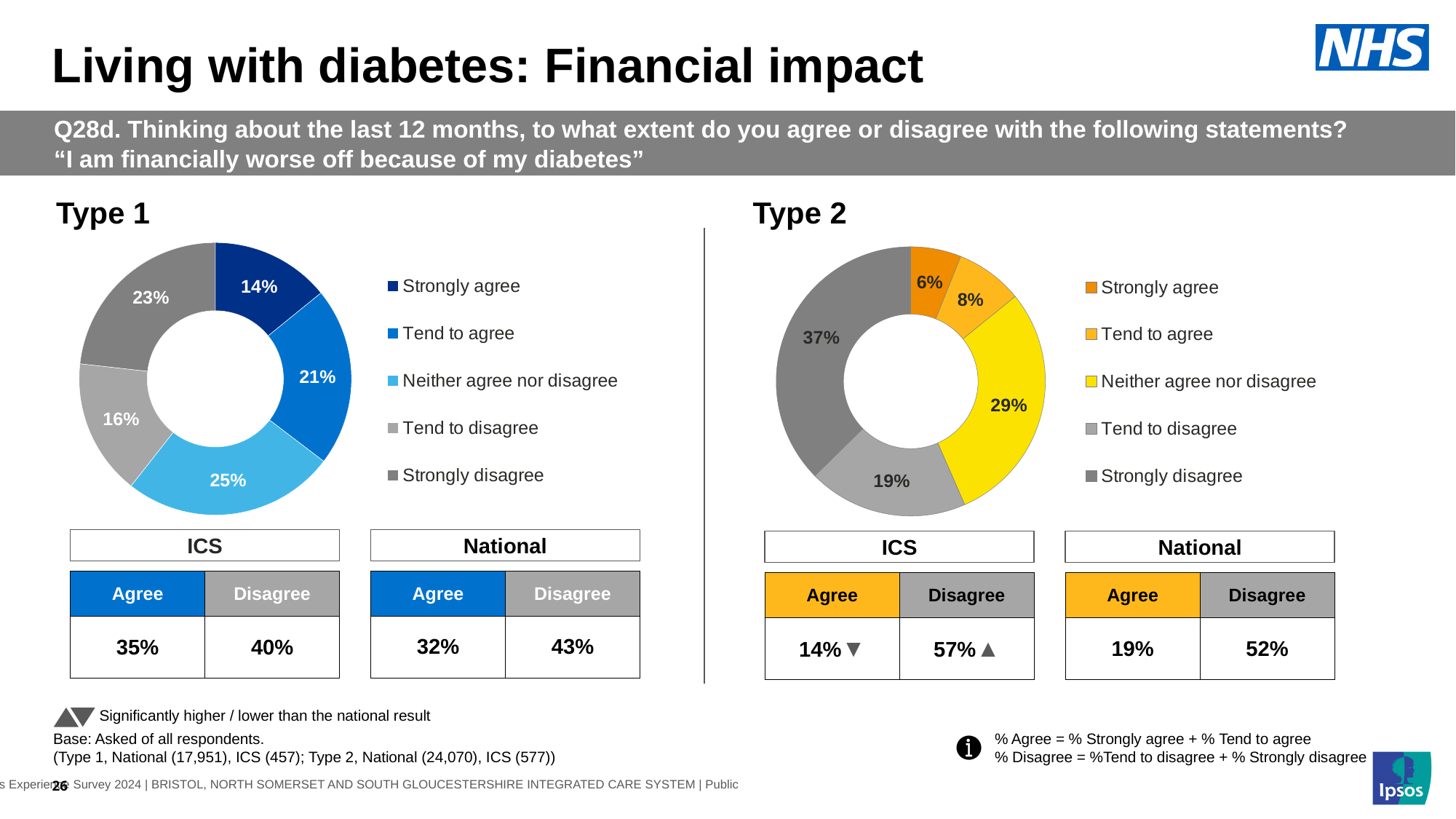
In the Type 1 chart, what percentage of respondents said 'Strongly agree'? 14% In the Type 1 chart, which response category has the largest share? Neither agree nor disagree In the Type 2 chart, what percentage of respondents said 'Tend to agree'? 8% What kind of chart is used for the Type 1 data? Donut (pie) chart In the Type 2 chart, what colour represents 'Neither agree nor disagree'? Yellow In the Type 2 chart, what is the difference between the 'Strongly disagree' share and the 'Tend to disagree' share? 18% In the Type 1 chart, what is the difference between the 'Strongly disagree' share and the 'Tend to disagree' share? 7% How many response categories are shown in the Type 2 chart? 5 Which is larger in the Type 1 chart: the 'Tend to agree' share or the 'Tend to disagree' share? Tend to agree In the Type 2 chart, what percentage of respondents said 'Neither agree nor disagree'? 29% In the Type 2 chart, which response category has the smallest share? Strongly agree In the Type 2 chart, which response category has the largest share? Strongly disagree